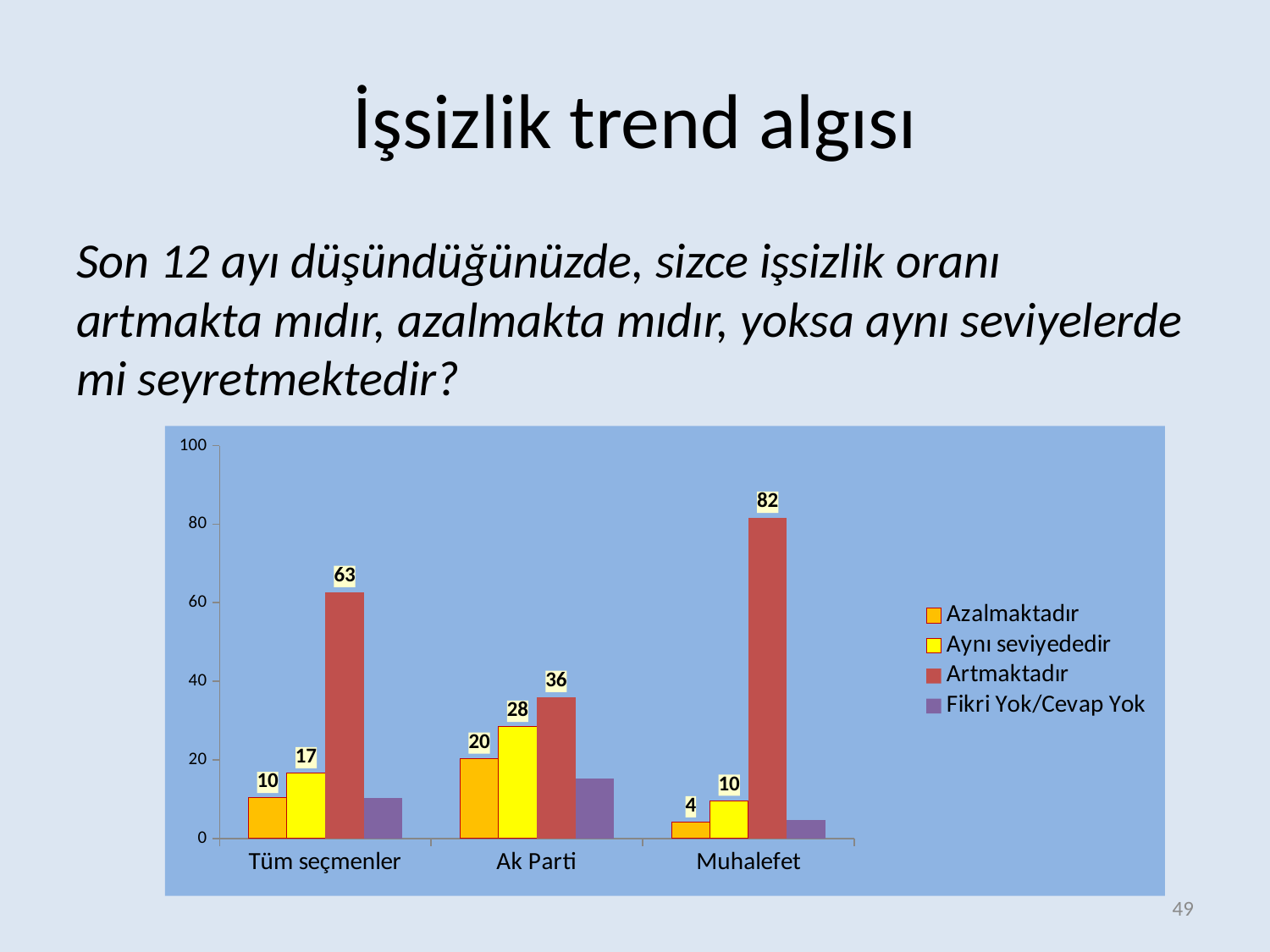
What is the value for Azalmaktadır in the Ak Parti group? 20 Which group has the highest value for Artmaktadır? Muhalefet What is the value for Aynı seviyededir in the Tüm seçmenler group? 17 What is the value for Artmaktadır in the Muhalefet group? 82 How many series does the legend list? 4 What is the difference between the Artmaktadır values for Muhalefet and Ak Parti? 46 What kind of chart is shown on the slide? bar chart Which group has the larger value for Aynı seviyededir, Ak Parti or Tüm seçmenler? Ak Parti What colour represents Artmaktadır in the legend? red Is the value for Fikri Yok/Cevap Yok in the Ak Parti group greater or less than 20? less Which group has the lowest value for Azalmaktadır? Muhalefet How many groups are shown on the x axis? 3